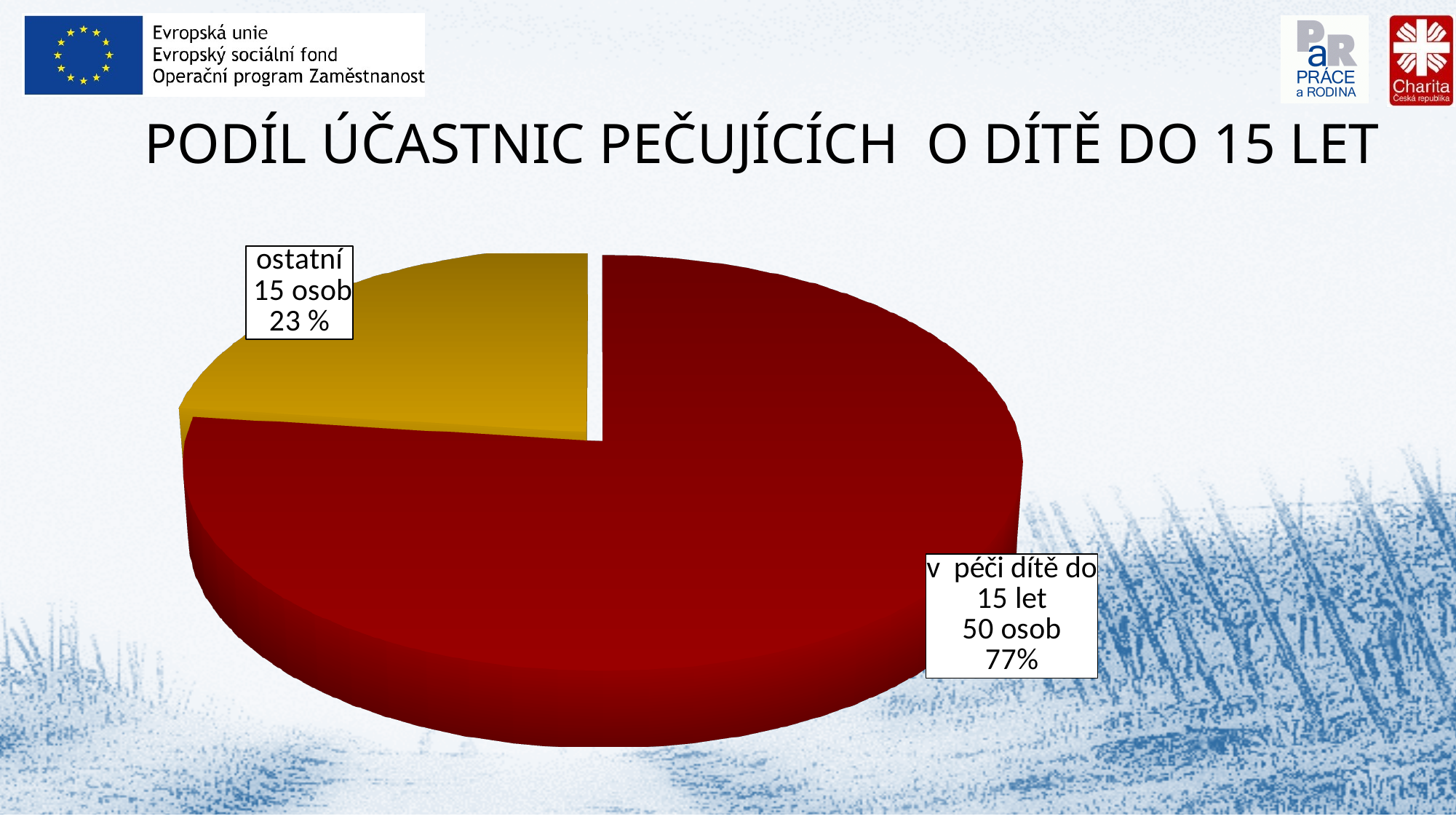
What colour is the 'ostatní' slice? yellow What percentage share does the 'v péči dítě do 15 let' slice have? 77% How many slices does the pie chart have? 2 Which slice is the largest? v péči dítě do 15 let What is the total number of people across both slices? 65 osob Which slice is the smallest? ostatní How many people are in the 'ostatní' slice? 15 osob How many people are in the 'v péči dítě do 15 let' slice? 50 osob What kind of chart is shown on the slide? pie chart What percentage share does the 'ostatní' slice have? 23 % Which slice has more people, 'ostatní' or 'v péči dítě do 15 let'? v péči dítě do 15 let What is the difference in number of people between the 'v péči dítě do 15 let' slice and the 'ostatní' slice? 35 osob